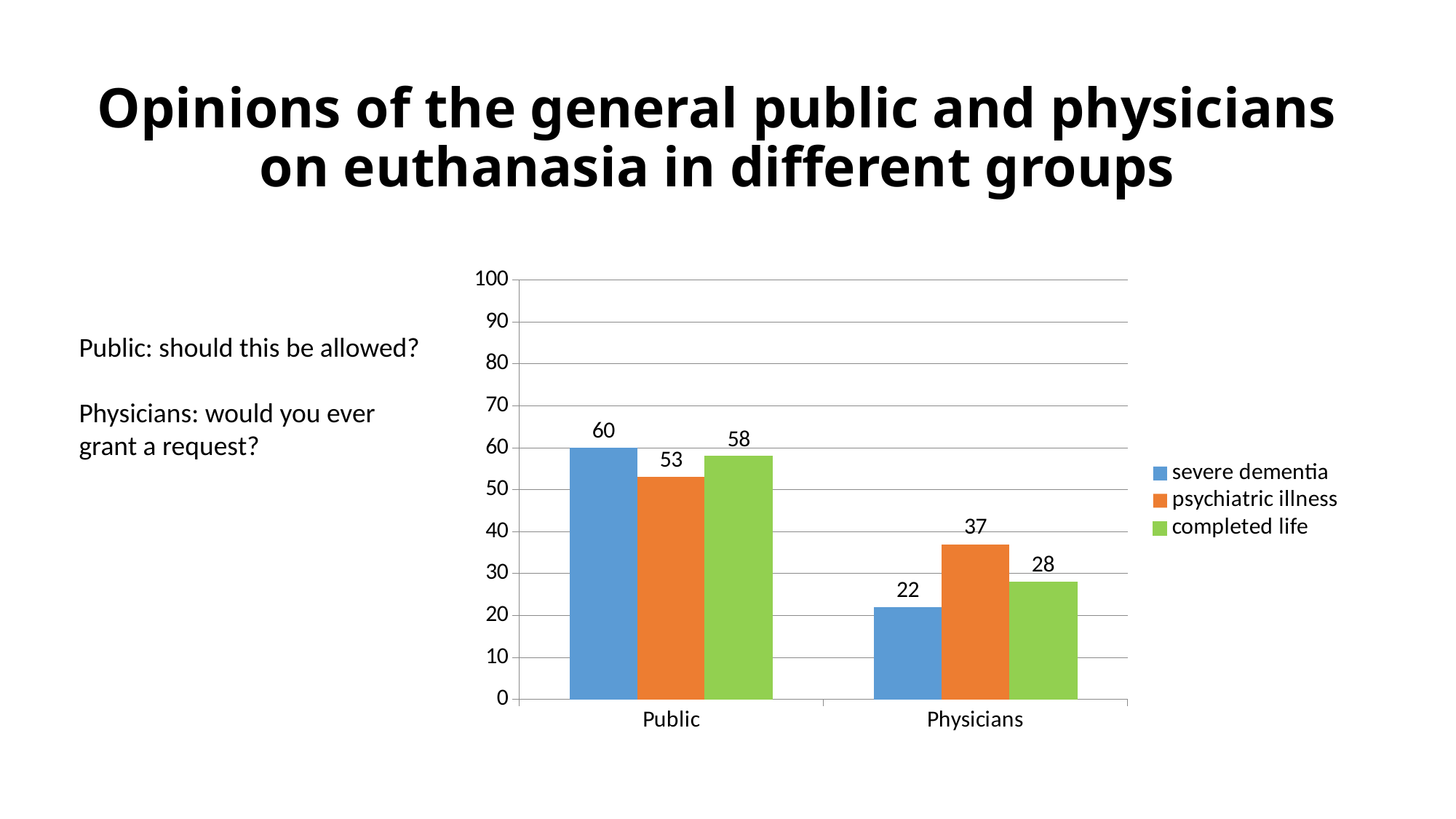
What is the value for severe dementia in the Public group? 60 Which series has the highest value in the Physicians group? psychiatric illness How many categories are shown on the x axis? 2 What kind of chart is shown on the slide? bar chart What is the difference between the severe dementia values for Public and Physicians? 38 Which series has the lowest value in the Public group? psychiatric illness How many series does the legend list? 3 What is the value for completed life in the Public group? 58 Which is larger: the psychiatric illness value for Public or for Physicians? Public What is the difference between the completed life values for Public and Physicians? 30 Which colour represents completed life in the legend? green What is the value for psychiatric illness in the Physicians group? 37